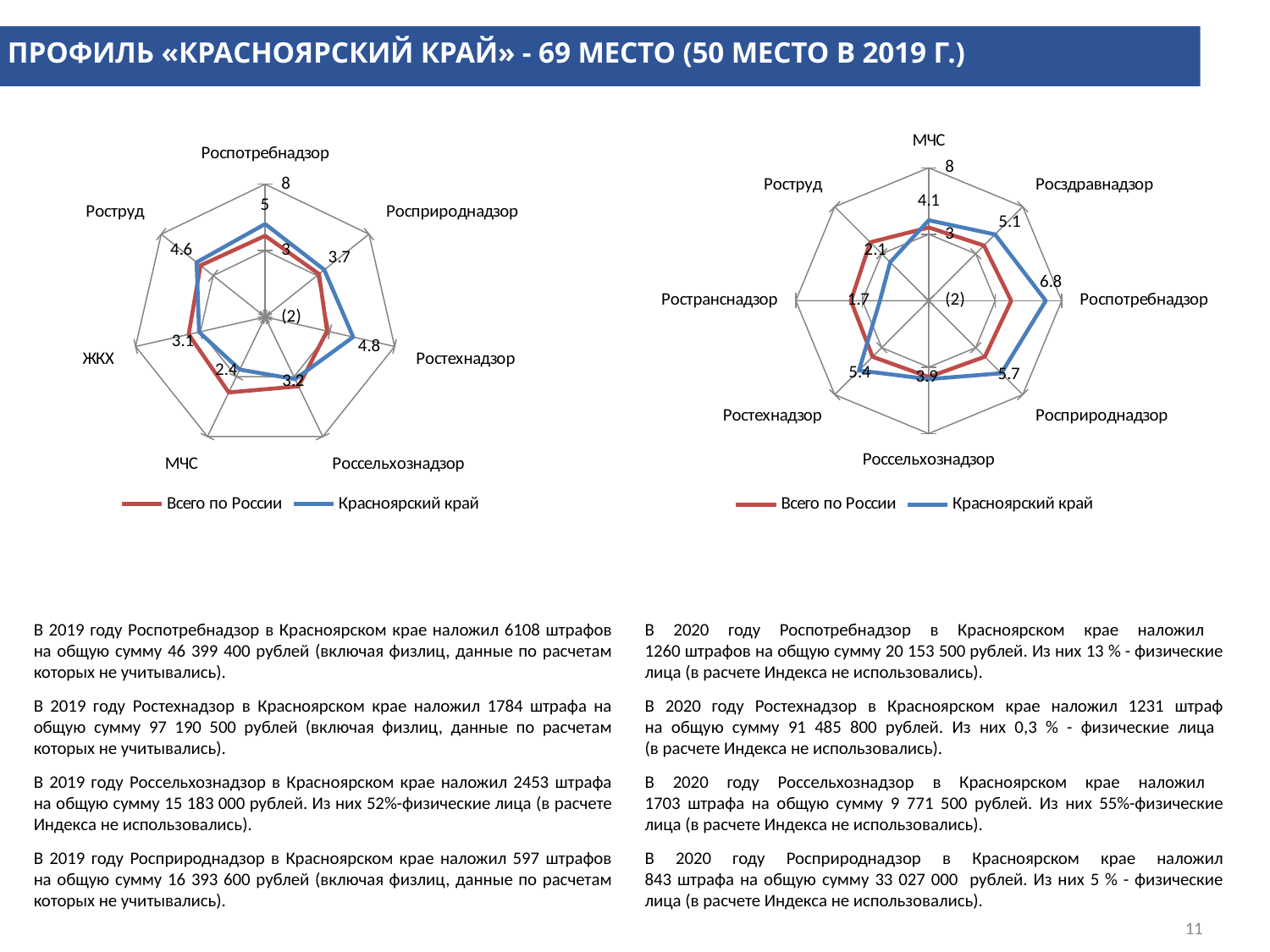
In the right chart, which category has the lowest value for Красноярский край? Ространснадзор What kind of chart is the left chart on the slide? Radar chart In the right chart, what is the value for Красноярский край at Роспотребнадзор? 6.8 In the right chart, which series is drawn in blue? Красноярский край In the left chart, what is the value for Красноярский край at Роструд? 4.6 In the right chart, what is the difference between the Красноярский край values for Роспотребнадзор and Росприроднадзор? 1.1 In the left chart, which category has the lowest value for Красноярский край? МЧС How many categories (axes) does the right chart have? 8 In the left chart, what is the value for Красноярский край at Ростехнадзор? 4.8 In the left chart, which category has the highest value for Красноярский край? Роспотребнадзор How many categories (axes) does the left chart have? 7 How many series does the legend of the left chart list? 2